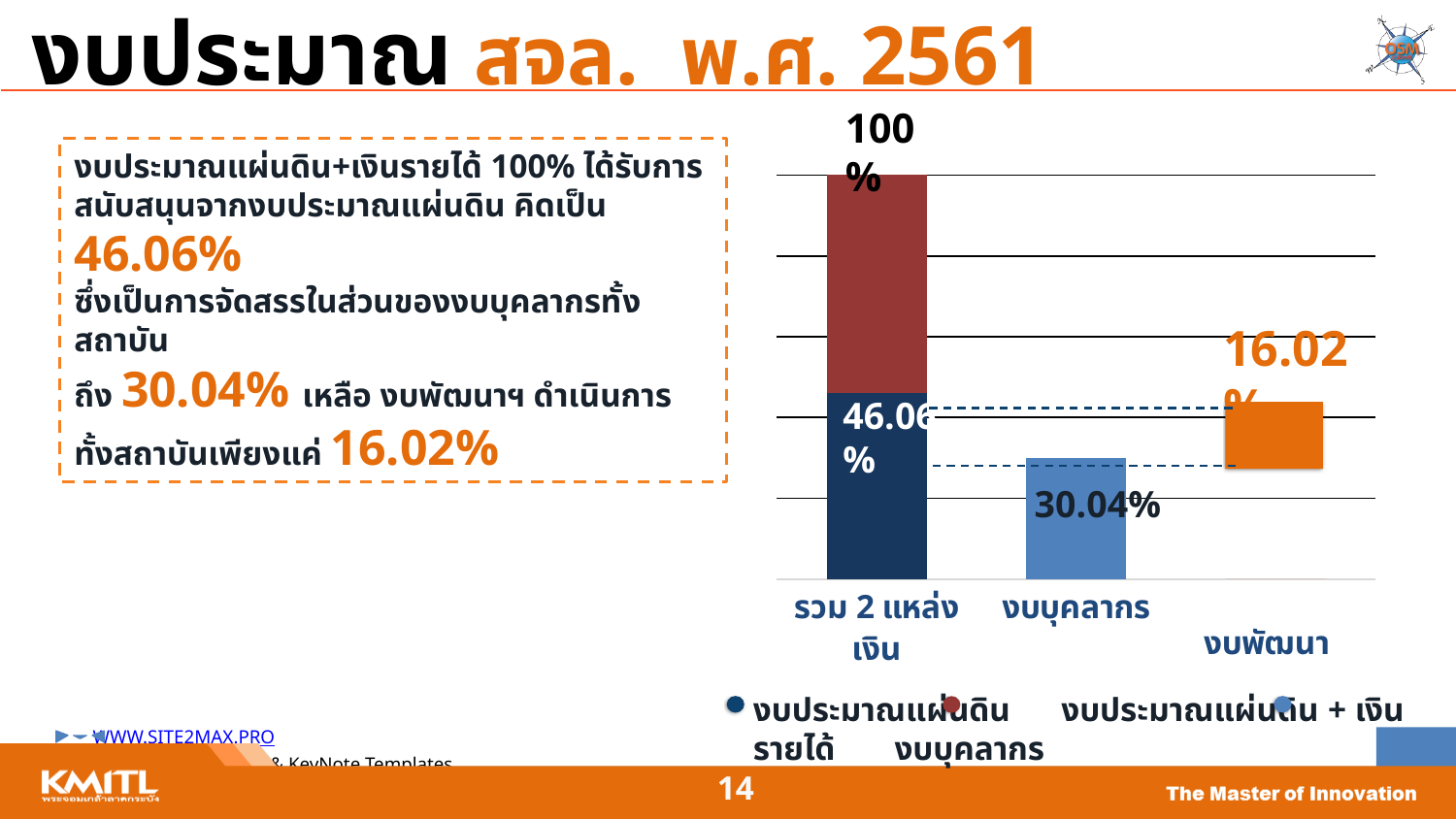
Which category has the lowest bar in the chart? งบพัฒนา Which is larger, งบบุคลากร or งบพัฒนา? งบบุคลากร What is the value shown for งบพัฒนา? 16.02% What is the difference between the values for งบบุคลากร and งบพัฒนา? 14.02% What is the total of the stacked bar for รวม 2 แหล่งเงิน? 100% What is the value of the dark blue (งบประมาณแผ่นดิน) portion of the รวม 2 แหล่งเงิน bar? 46.06% What colour is the bar for งบพัฒนา? orange What kind of chart is shown on the slide? bar chart What is the value shown for งบบุคลากร? 30.04% What is the difference between the งบประมาณแผ่นดิน portion (46.06%) and the งบบุคลากร value? 16.02% How many categories are shown on the x axis of the chart? 3 Which category has the tallest bar in the chart? รวม 2 แหล่งเงิน